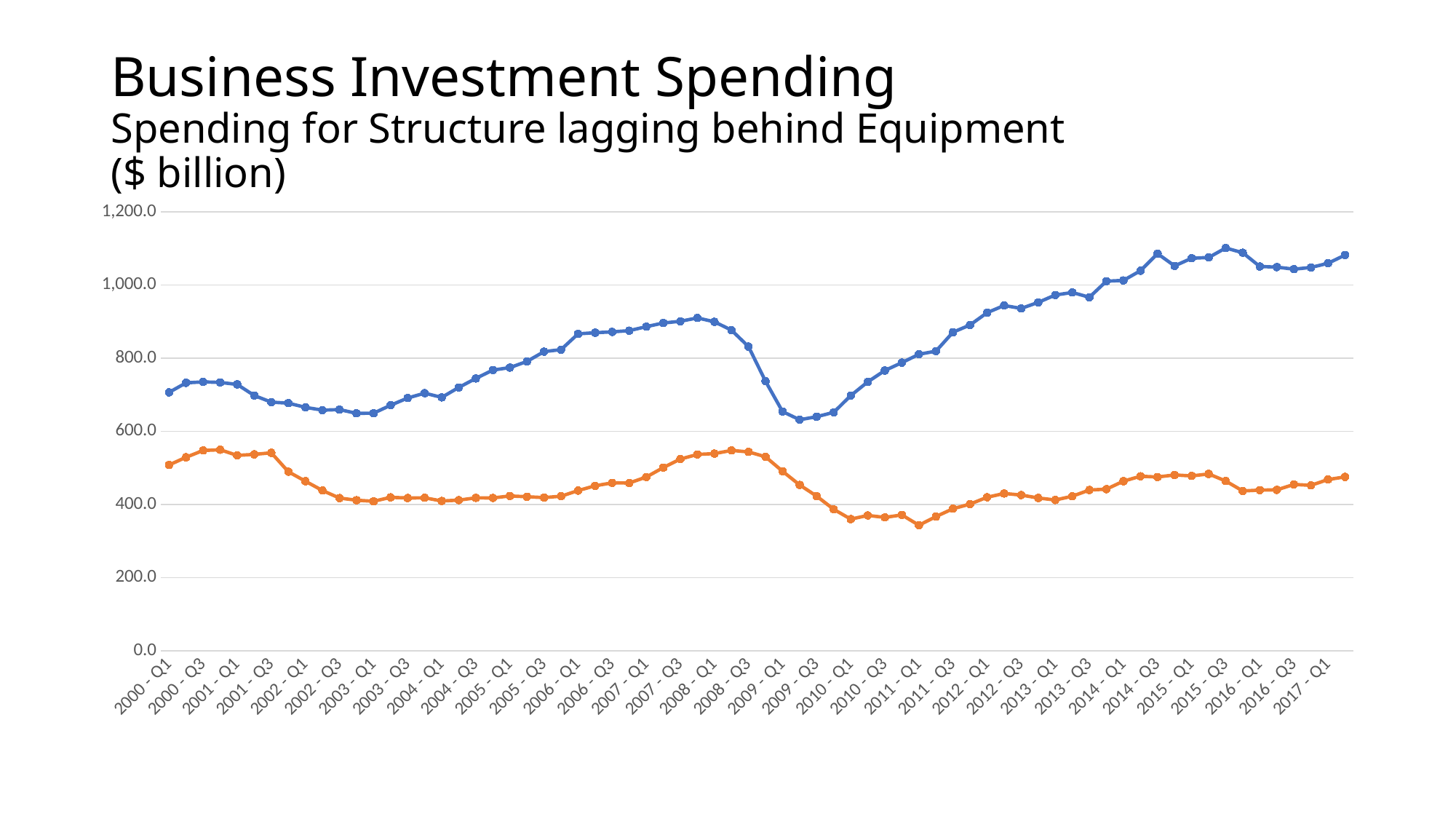
Is the value of the blue line at 2000 - Q1 greater or less than 600.0? greater Does the blue line rise or fall between 2009 - Q3 and 2015 - Q3? rise In what unit are the values on the chart expressed, according to the slide? $ billion Is the value of the orange line at 2008 - Q1 greater or less than 400.0? greater For the blue line, is the value at 2017 - Q1 higher or lower than the value at 2000 - Q1? higher Is the value of the blue line at 2009 - Q3 greater or less than 800.0? less How many lines are plotted on the chart? 2 What kind of chart is shown on the slide? line chart What is the title of the chart on the slide? Business Investment Spending At 2010 - Q1, which line has the higher value, the blue line or the orange line? the blue line